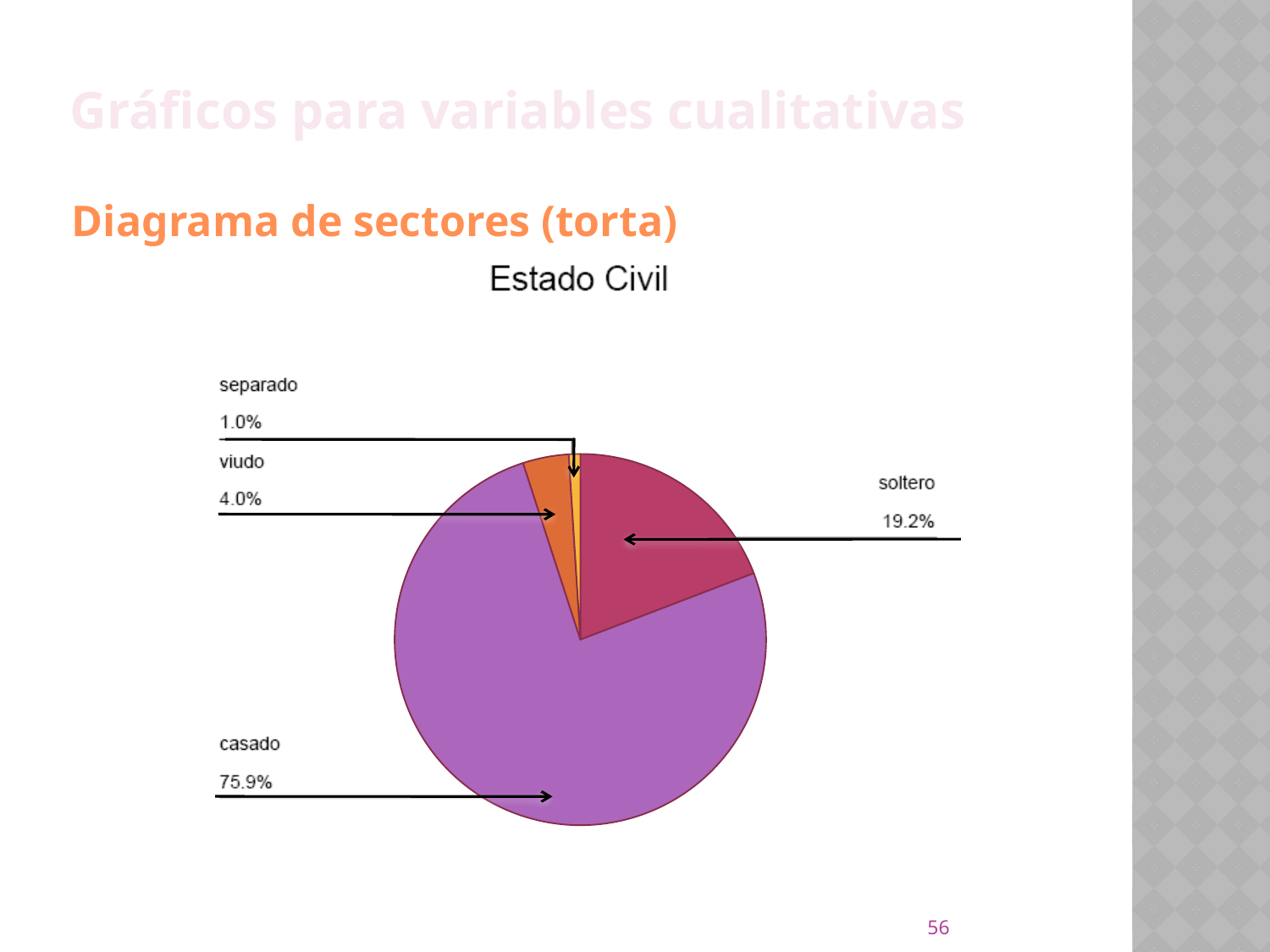
What percentage does the 'casado' slice represent? 75.9% What is the difference in percentage points between 'casado' and 'soltero'? 56.7 What type of chart is shown on the slide? pie chart How many categories are shown in the pie chart? 4 Which category has the smallest share of the pie? separado What colour is the 'casado' slice? purple What percentage does the 'viudo' slice represent? 4.0% Which category has the largest share of the pie? casado What percentage does the 'soltero' slice represent? 19.2% Which is larger, the share for 'viudo' or the share for 'separado'? viudo What is the title of the chart? Estado Civil What percentage does the 'separado' slice represent? 1.0%